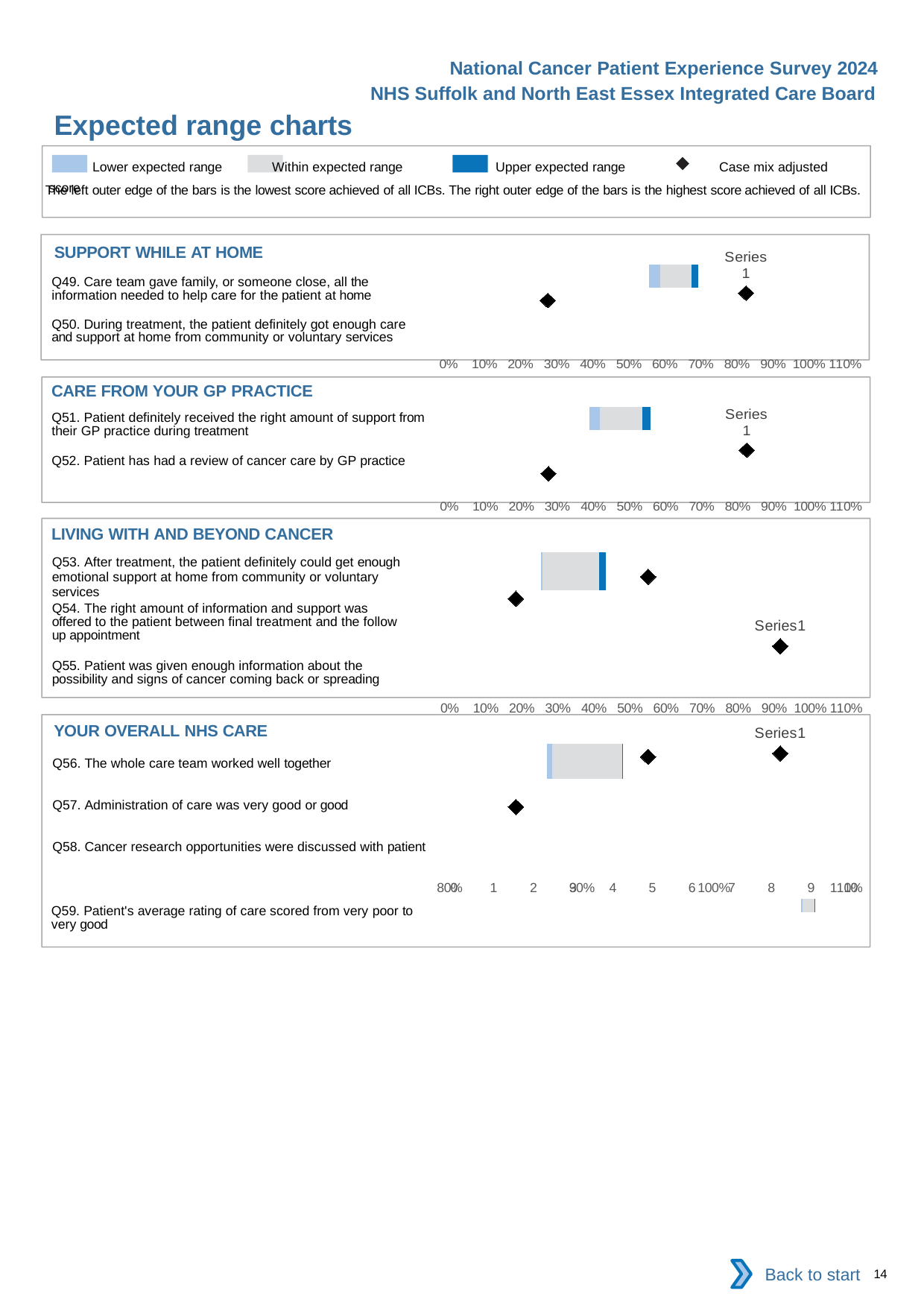
How many entries does the legend at the top of the slide list? 4 How many questions are listed in the 'YOUR OVERALL NHS CARE' chart? 4 How many questions are listed in the 'SUPPORT WHILE AT HOME' chart? 2 What is the highest tick label on the x axis of the 'CARE FROM YOUR GP PRACTICE' chart? 110% How many questions are listed in the 'CARE FROM YOUR GP PRACTICE' chart? 2 According to the legend, what does the black diamond marker represent? Case mix adjusted score What kind of chart is used in the 'SUPPORT WHILE AT HOME' section? bar chart In the 'LIVING WITH AND BEYOND CANCER' chart, is the leftmost diamond marker greater or less than 30%? less In the 'SUPPORT WHILE AT HOME' chart, is the leftmost diamond marker greater or less than 40%? less What is the title of the slide containing the charts? Expected range charts